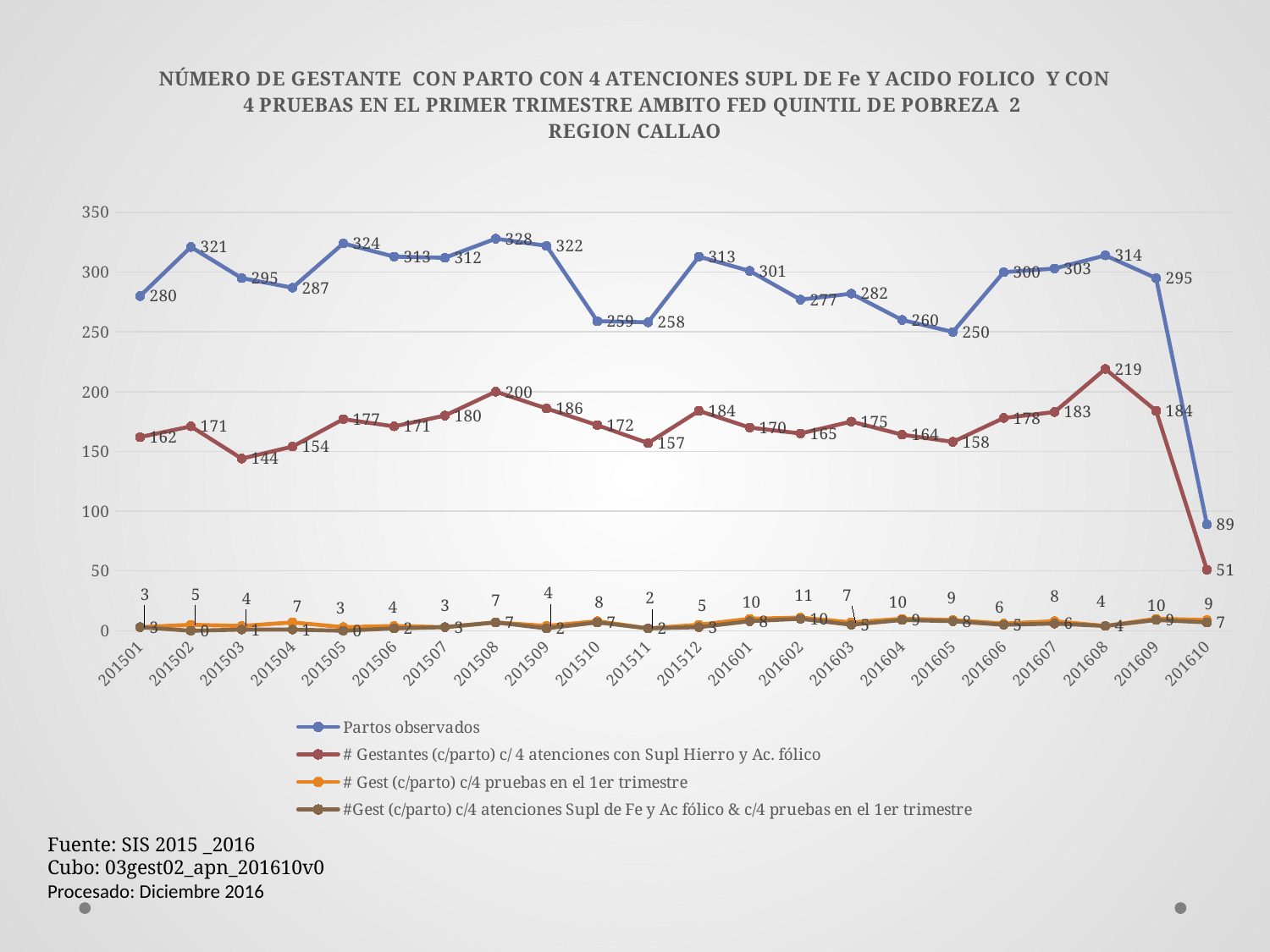
How many time periods are plotted along the x axis? 22 Is the value of Partos observados for 201605 greater or less than 300? less What is the value of # Gestantes (c/parto) c/ 4 atenciones con Supl Hierro y Ac. fólico for 201608? 219 What is the value of Partos observados for 201508? 328 What is the difference between Partos observados in 201609 and 201610? 206 What is the value of # Gest (c/parto) c/4 pruebas en el 1er trimestre for 201602? 11 What is the value of #Gest (c/parto) c/4 atenciones Supl de Fe y Ac fólico & c/4 pruebas en el 1er trimestre for 201610? 7 What type of chart is shown on the slide? Line chart In which period is # Gestantes (c/parto) c/ 4 atenciones con Supl Hierro y Ac. fólico highest? 201608 Which is larger, Partos observados in 201502 or in 201505? 201505 How many series does the legend list? 4 In which period is Partos observados lowest? 201610